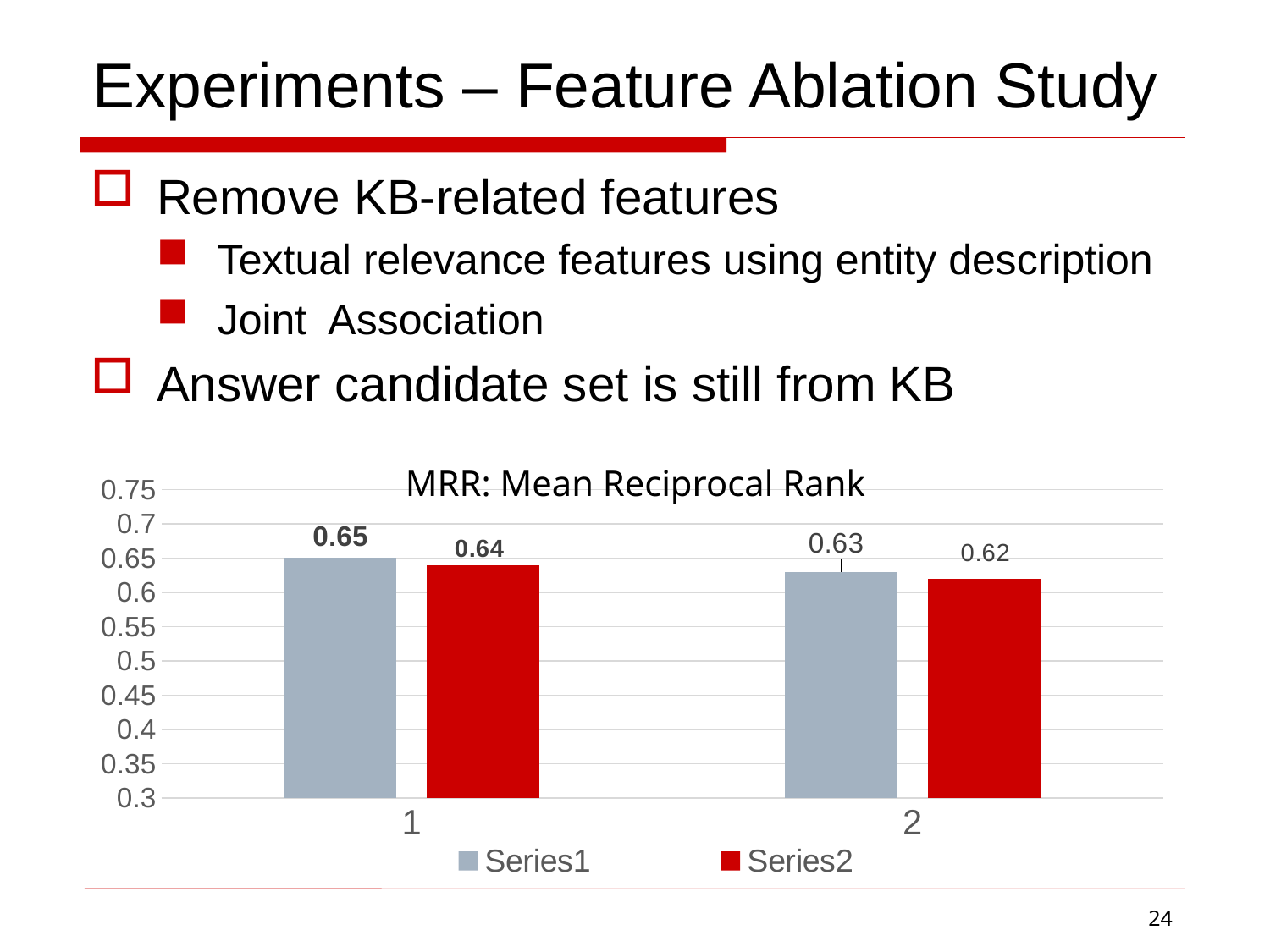
What is the value of Series1 for category 2? 0.63 What kind of chart is shown on the slide? Bar chart What is the value of Series2 for category 1? 0.64 What is the value of Series2 for category 2? 0.62 How many series does the legend list? 2 What is the value of Series1 for category 1? 0.65 What is the difference between Series1 and Series2 for category 1? 0.01 What is the difference between the Series1 values for category 1 and category 2? 0.02 Which is larger, Series1 for category 1 or Series1 for category 2? Series1 for category 1 Which bar has the highest value in the chart? Series1 for category 1 Which bar has the lowest value in the chart? Series2 for category 2 What is the title of the chart? MRR: Mean Reciprocal Rank